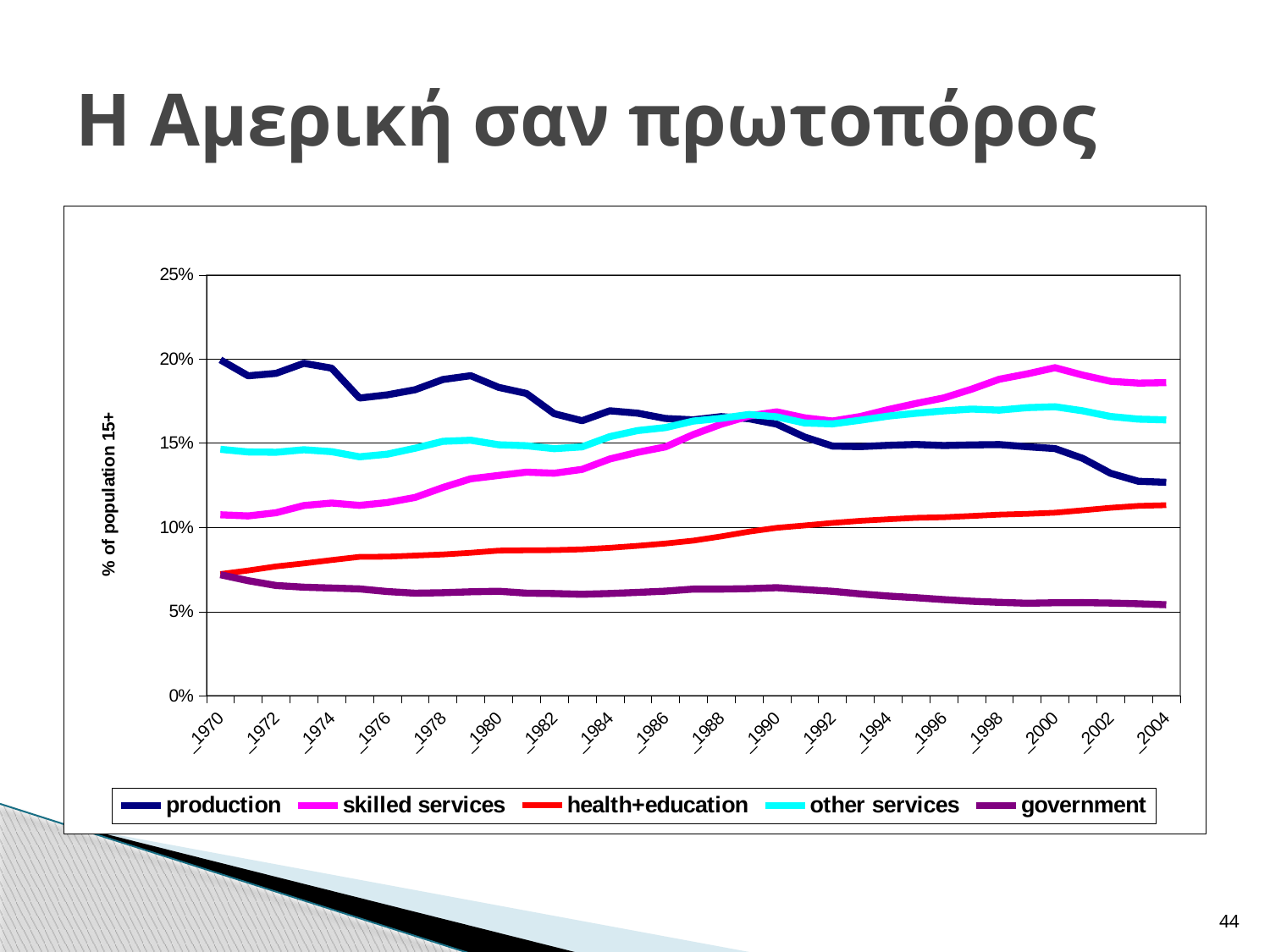
Is the value for skilled services in 2000 greater or less than 15%? greater Does the health+education series rise or fall between 1970 and 2004? rise In 2004, which is larger: skilled services or production? skilled services Does the government series rise or fall between 1970 and 2004? fall Is the value for government in 2004 greater or less than 10%? less Does the skilled services series rise or fall between 1970 and 2004? rise What is the label on the vertical axis? % of population 15+ Is the value for production in 1970 greater or less than 15%? greater How many series does the legend list? 5 What kind of chart is shown on the slide? line chart Which series has the lowest value in 2004? government